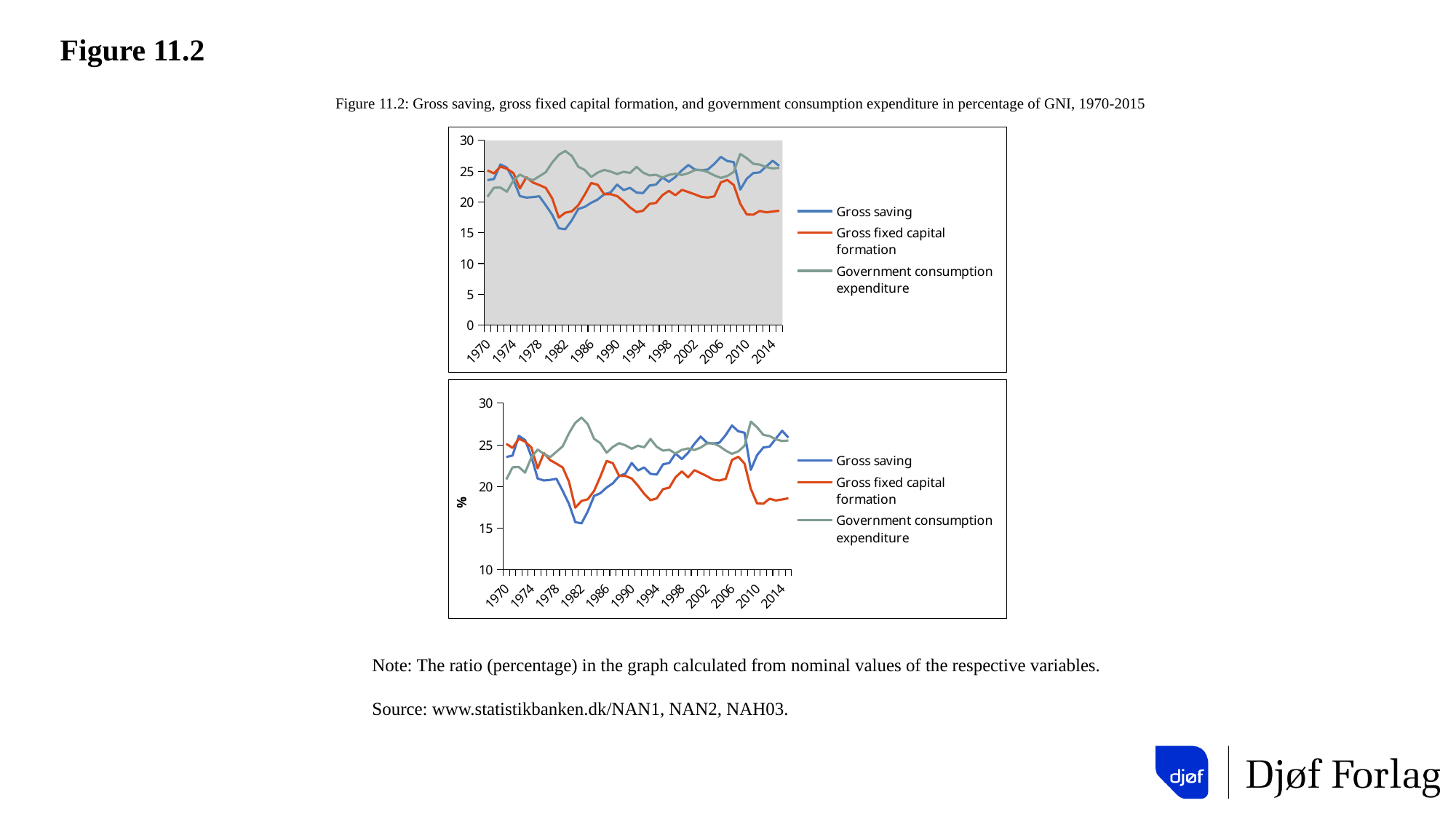
What kind of chart is the top chart on the slide? line chart In the bottom chart, which is larger in 2014: Gross saving or Gross fixed capital formation? Gross saving How many series does the legend of the bottom chart list? 3 In the top chart, which is larger in 1982: Gross saving or Government consumption expenditure? Government consumption expenditure In the top chart, does Gross saving rise or fall between 1982 and 1990? rise In the bottom chart, is the value for Gross fixed capital formation in 2014 greater or less than 20? less What is the y-axis label of the bottom chart? % In the bottom chart, does Gross fixed capital formation rise or fall between 2006 and 2010? fall In the top chart, is the value for Government consumption expenditure in 1982 greater or less than 25? greater In the top chart, is the value for Gross saving in 1982 greater or less than 20? less What is the lowest value shown on the y-axis of the bottom chart? 10